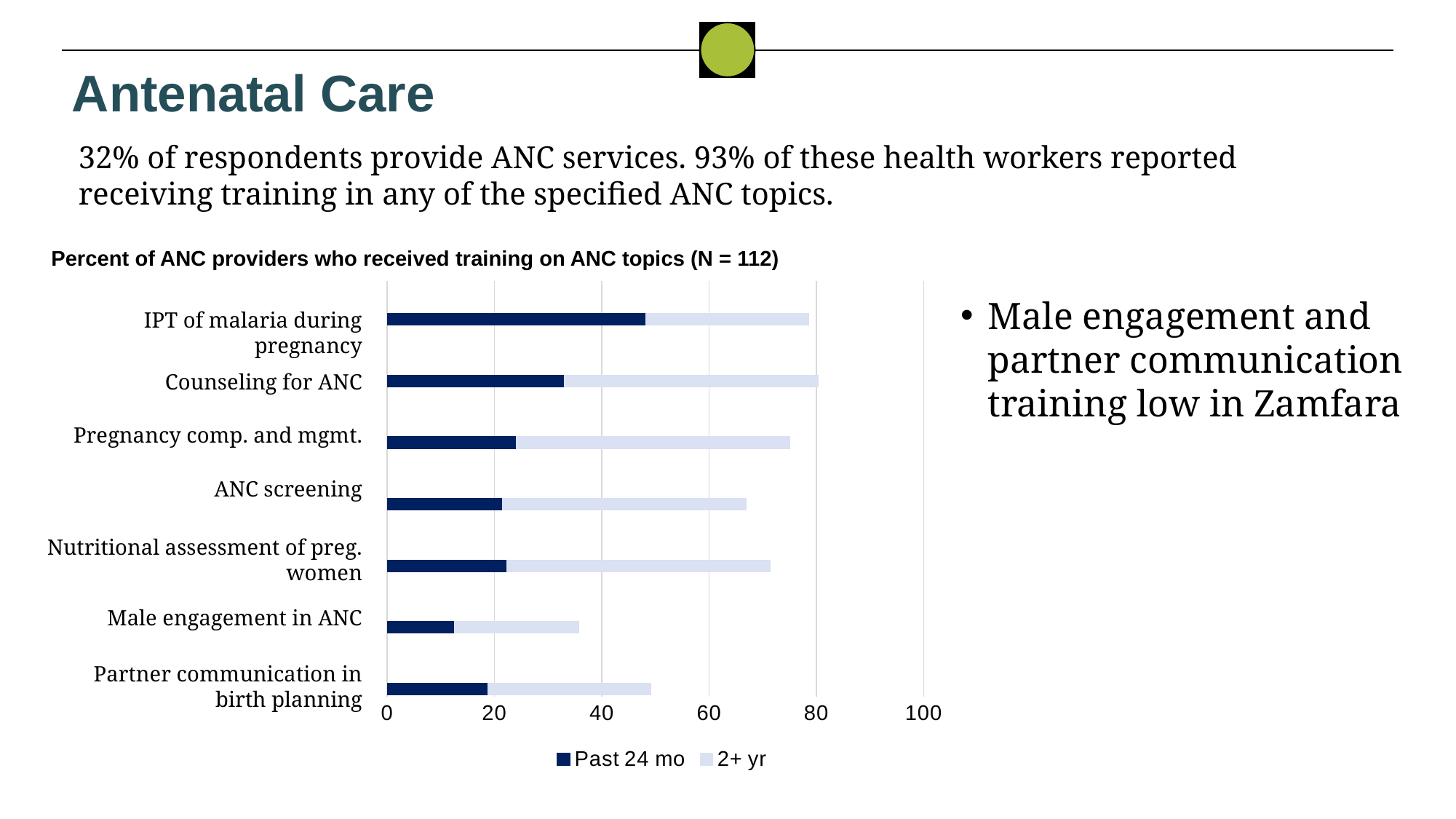
Which ANC topic has the lowest total bar length (Past 24 mo plus 2+ yr)? Male engagement in ANC Which has the larger Past 24 mo value: Counseling for ANC or Pregnancy comp. and mgmt.? Counseling for ANC What are the two series named in the chart legend? Past 24 mo and 2+ yr What is the title of the chart? Percent of ANC providers who received training on ANC topics (N = 112) Is the total bar length for Partner communication in birth planning greater or less than 60? less What kind of chart is shown on the slide? Stacked bar chart Is the total bar length for Pregnancy comp. and mgmt. greater or less than 60? greater How many ANC topics (categories) are plotted in the chart? 7 Which ANC topic has the lowest value for the Past 24 mo series? Male engagement in ANC Which ANC topic has the highest value for the Past 24 mo series? IPT of malaria during pregnancy Is the Past 24 mo value for IPT of malaria during pregnancy greater or less than 40? greater How many series does the chart legend list? 2